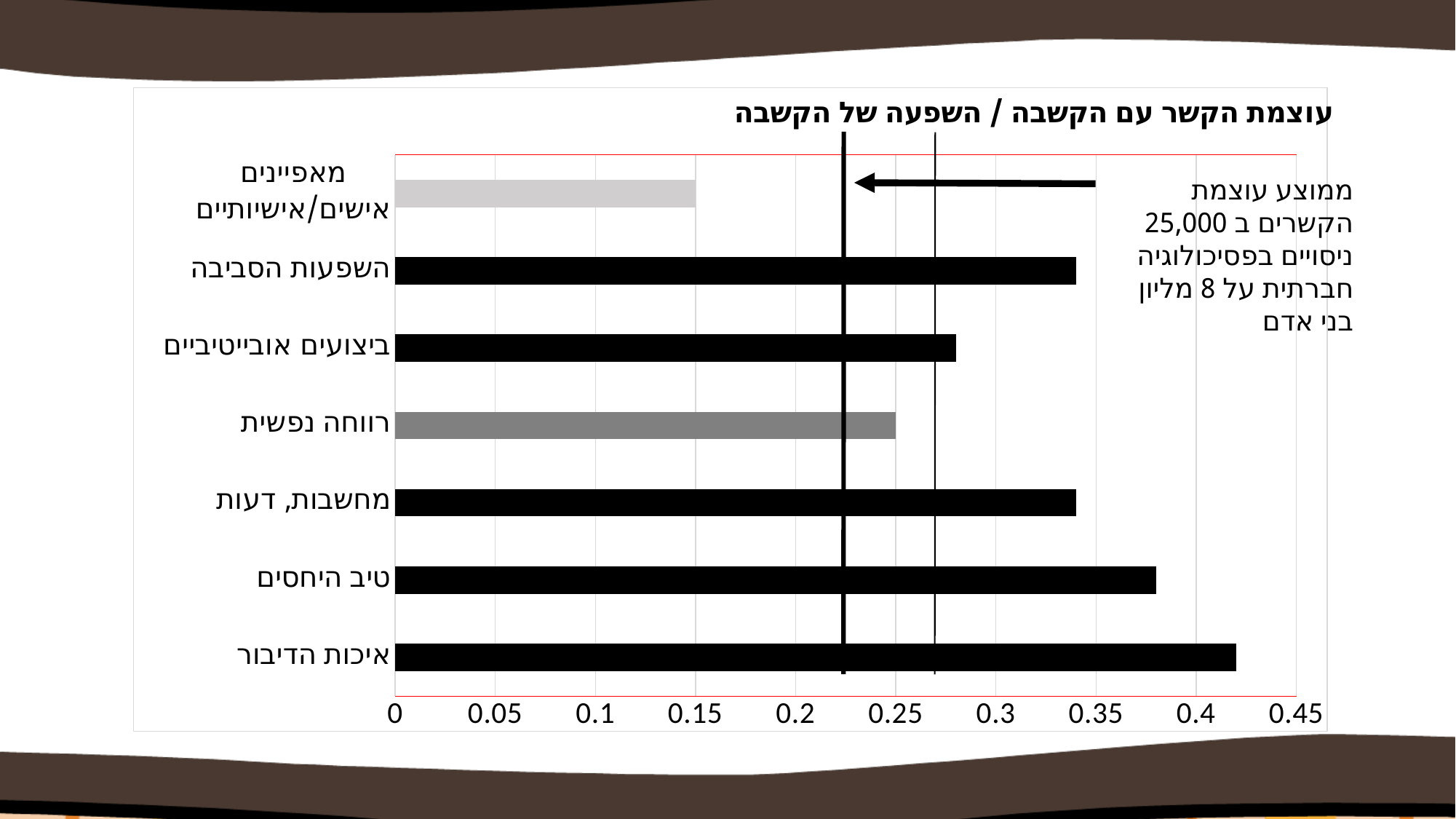
How many categories are plotted in the chart? 7 What kind of chart is shown on the slide? bar chart What is the title of the chart? עוצמת הקשר עם הקשבה / השפעה של הקשבה What is the value for מאפיינים אישים/אישיותיים? 0.15 What is the value for רווחה נפשית? 0.25 Is the value for ביצועים אובייטיביים greater or less than 0.3? less Which category has the highest value in the chart? איכות הדיבור According to the annotation next to the chart, how many experiments does the average correlation strength line represent? 25,000 Which category has the lowest value in the chart? מאפיינים אישים/אישיותיים Is the value for טיב היחסים greater or less than 0.35? greater Is the value for השפעות הסביבה greater or less than 0.3? greater Which is larger, the value for טיב היחסים or the value for רווחה נפשית? טיב היחסים